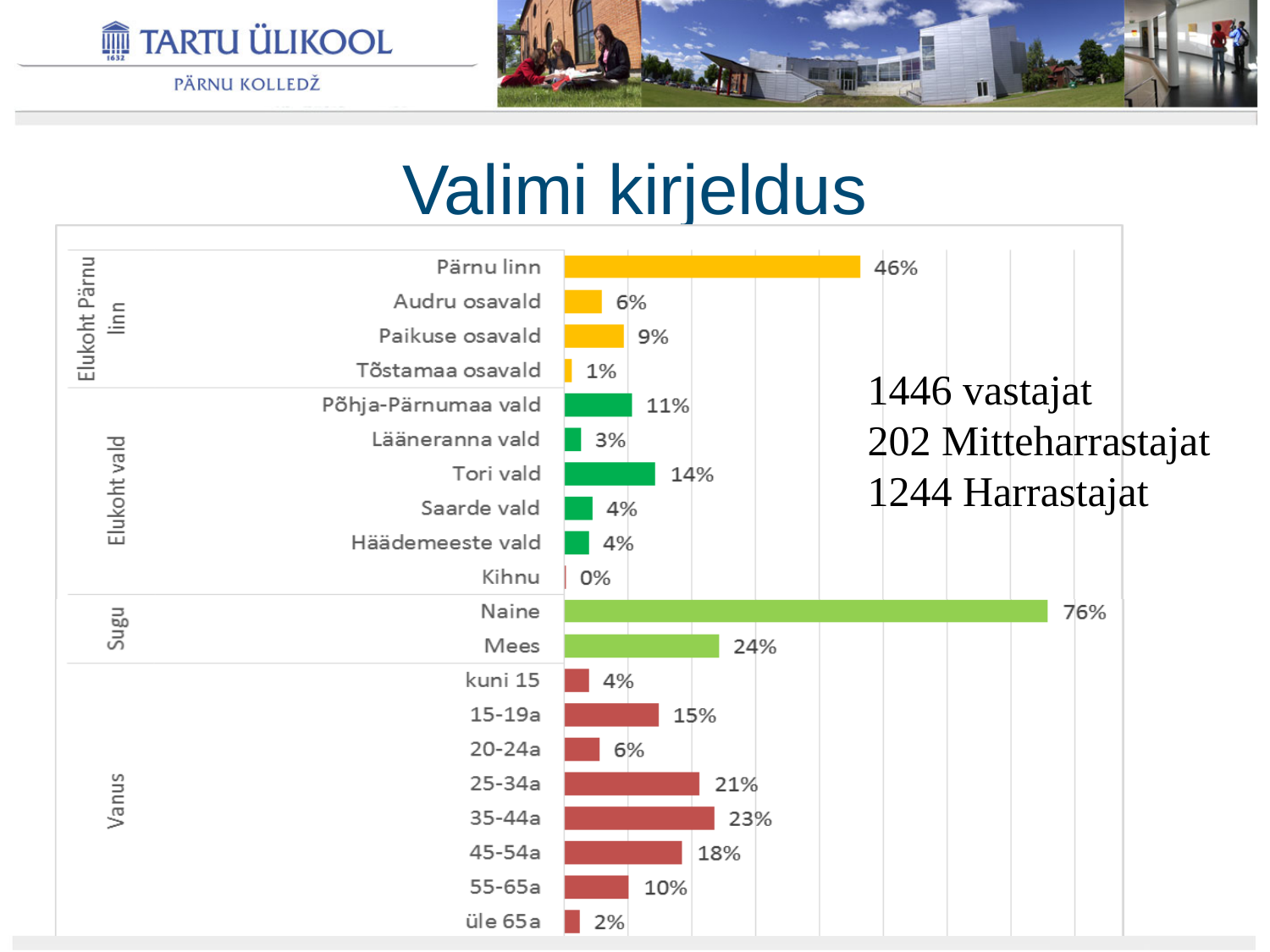
Which age group (Vanus) has the highest value? 35-44a What is the difference between the values for 25-34a and 45-54a? 3% What is the value for Pärnu linn? 46% What is the value for Naine? 76% What is the value for the 35-44a age group? 23% What is the difference between the values for Naine and Mees? 52% What is the title of the slide containing the chart? Valimi kirjeldus What is the value for Tori vald? 14% What kind of chart is shown on the slide? bar chart How many categories are plotted in the chart in total? 20 Which category in the Elukoht vald group has the lowest value? Kihnu Which is larger, the value for Paikuse osavald or Audru osavald? Paikuse osavald